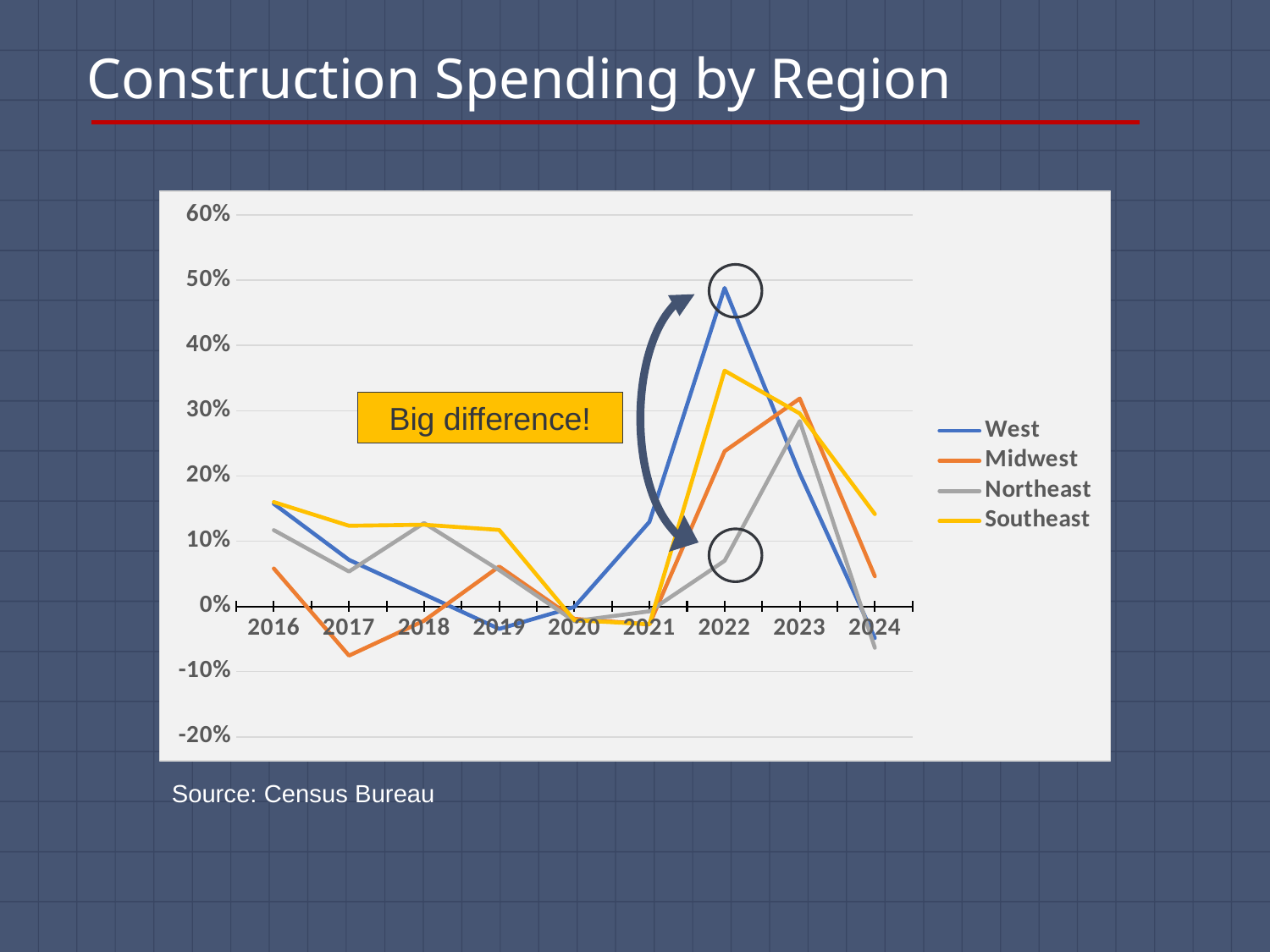
How many years are shown along the x axis? 9 Which region has the lowest value in 2022? Northeast Is the value for West in 2022 greater or less than 40%? greater Which region has the highest value in 2022? West In 2023, which is larger: the value for Midwest or the value for West? Midwest Which region has the highest value in 2024? Southeast Is the value for Midwest in 2017 greater or less than 0%? less How many series does the legend list? 4 What text is written in the yellow callout box on the chart? Big difference! What kind of chart is shown on the slide? Line chart Is the value for Northeast in 2022 greater or less than 10%? less Does the West line rise or fall from 2022 to 2024? Fall